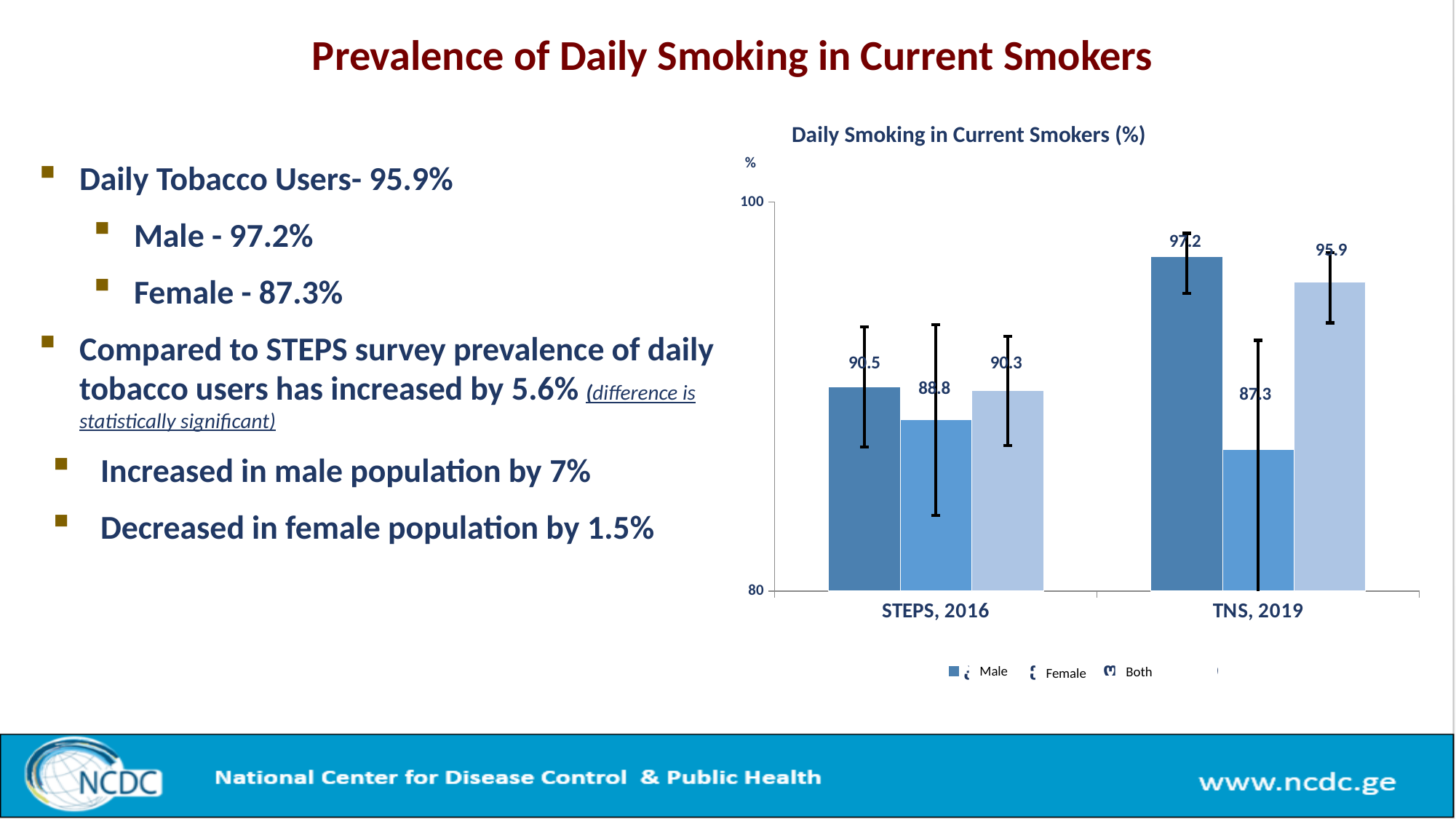
What is the value for Both in TNS, 2019? 95.9 Which is larger, the Female value in STEPS, 2016 or the Female value in TNS, 2019? STEPS, 2016 What is the value for Female in STEPS, 2016? 88.8 What is the title of the chart? Daily Smoking in Current Smokers (%) What is the value for Male in STEPS, 2016? 90.5 How many series does the legend list? 3 Which series has the highest value in TNS, 2019? Male What kind of chart is shown? Bar chart Which series has the lowest value in STEPS, 2016? Female What is the value for Female in TNS, 2019? 87.3 What is the difference between the Male values for TNS, 2019 and STEPS, 2016? 6.7 How many categories are shown on the x axis? 2